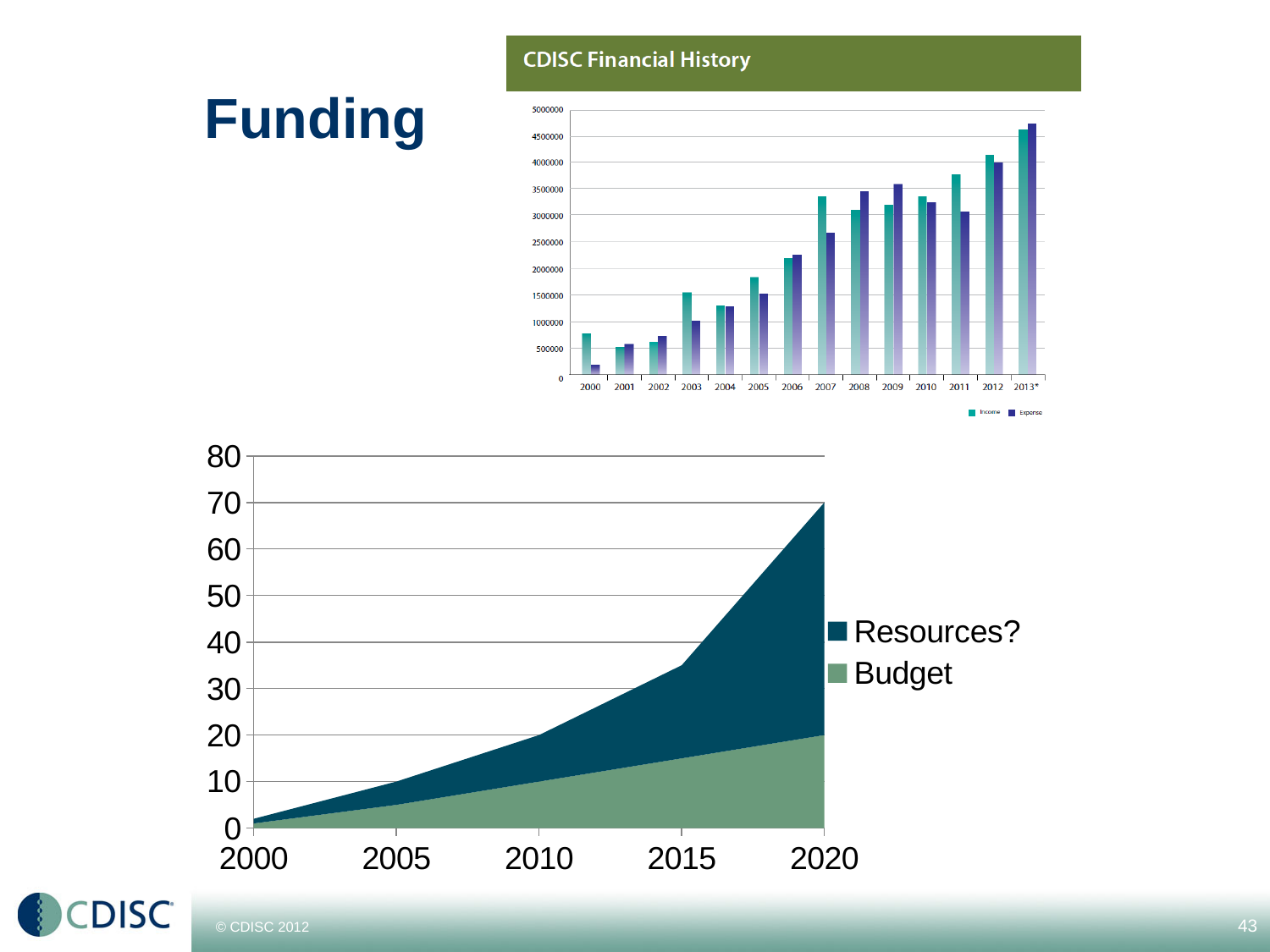
In the 'CDISC Financial History' chart, is the Expense value for 2000 greater or less than 500000? less In the bottom chart, do the stacked values rise or fall from 2000 to 2020? rise In the 'CDISC Financial History' chart, which year has the highest Income bar? 2013* What kind of chart is the bottom chart on the slide? area chart What kind of chart is the 'CDISC Financial History' chart at the top right of the slide? bar chart How many series does the legend of the 'CDISC Financial History' chart list? 2 In the 'CDISC Financial History' chart, which is larger for 2011, Income or Expense? Income How many years are shown on the x axis of the 'CDISC Financial History' chart? 14 In the 'CDISC Financial History' chart, is the Income value for 2013* greater or less than 4500000? greater What are the two legend entries of the bottom chart? Resources? and Budget In the bottom chart, what is the total stacked value at 2020? 70 In the 'CDISC Financial History' chart, which is larger for 2009, Income or Expense? Expense